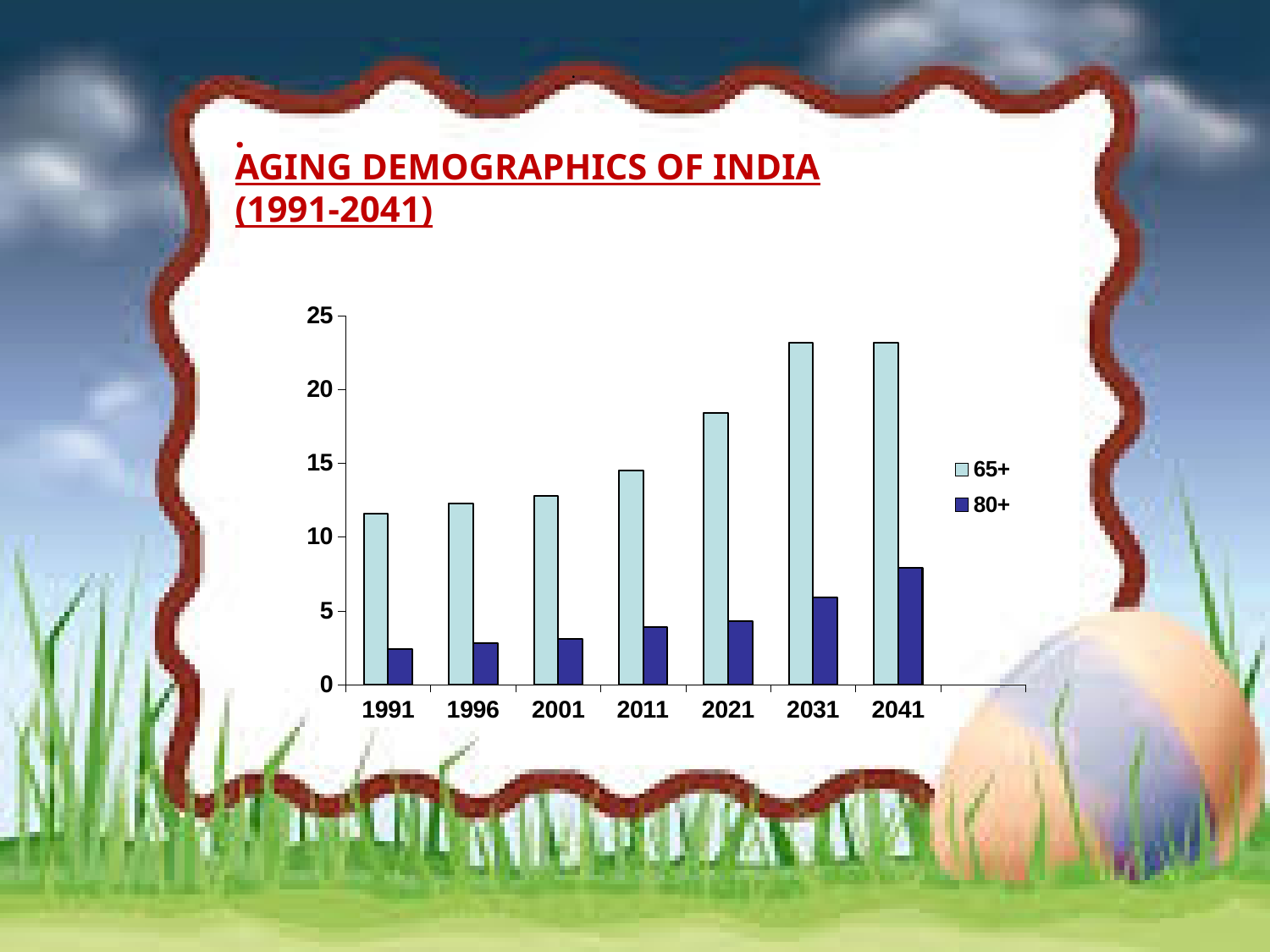
What is the title of the slide containing the chart? AGING DEMOGRAPHICS OF INDIA (1991-2041) Is the value for 80+ in 2041 greater or less than 5? greater Which year has the lowest value for the 65+ series? 1991 Is the value for 80+ in 1991 greater or less than 5? less In 2041, which series has the larger value, 65+ or 80+? 65+ How many series does the legend list? 2 How many years are shown on the x axis? 7 Is the value for 65+ in 2031 greater or less than 20? greater Which year has the highest value for the 80+ series? 2041 What kind of chart is shown on the slide? bar chart Do the values for the 80+ series rise or fall from 1991 to 2041? rise